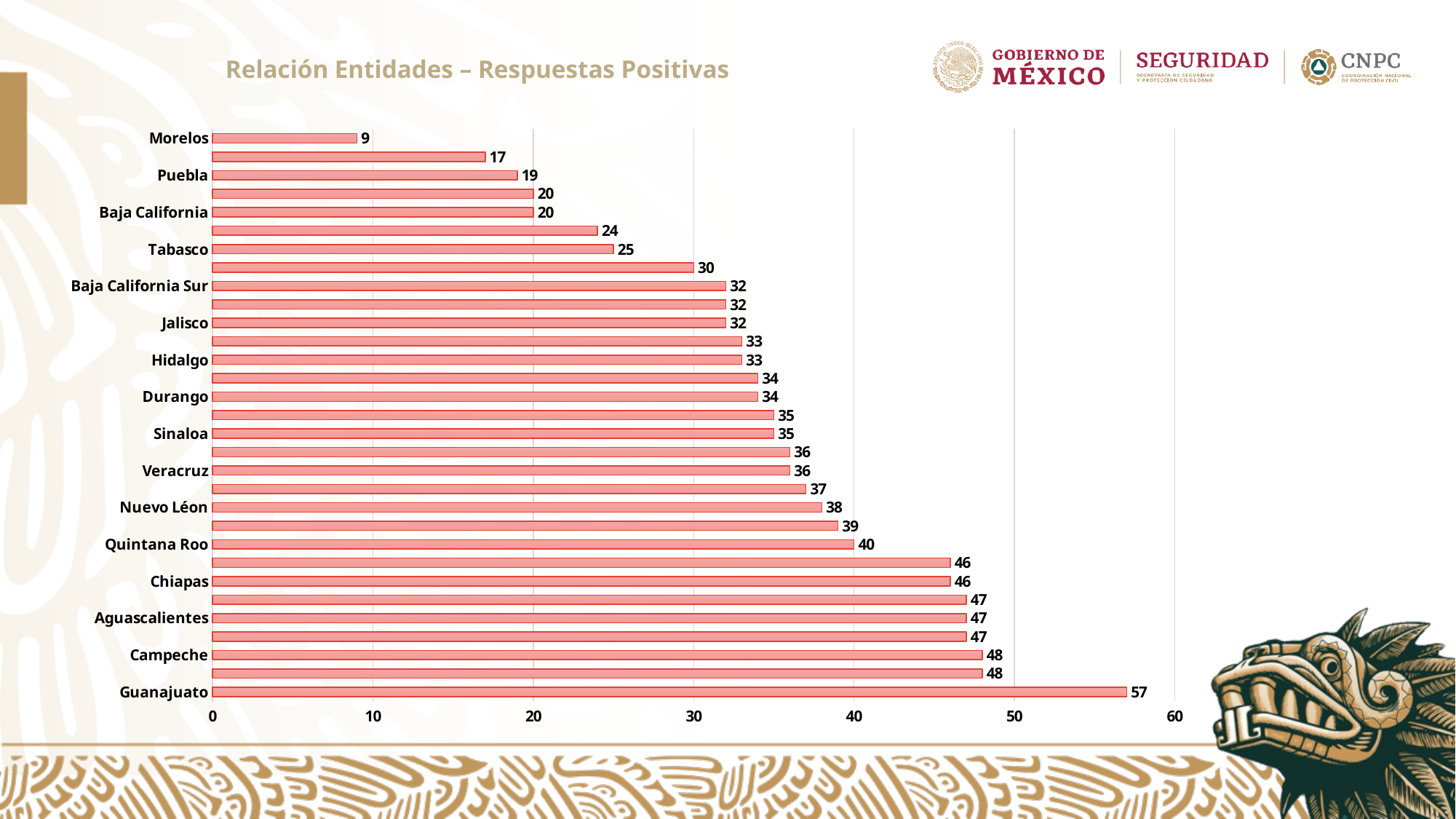
Which labeled entity has the lowest value? Morelos Is the value for Aguascalientes greater or less than 40? greater What kind of chart is shown on the slide? Bar chart What is the value for Morelos? 9 Which is larger, the value for Hidalgo or the value for Veracruz? Veracruz What is the difference between the values for Guanajuato and Morelos? 48 What is the value for Tabasco? 25 Which labeled entity has the highest value? Guanajuato What is the difference between the values for Campeche and Chiapas? 2 What is the value for Quintana Roo? 40 What is the title of the chart? Relación Entidades – Respuestas Positivas What is the value for Guanajuato? 57